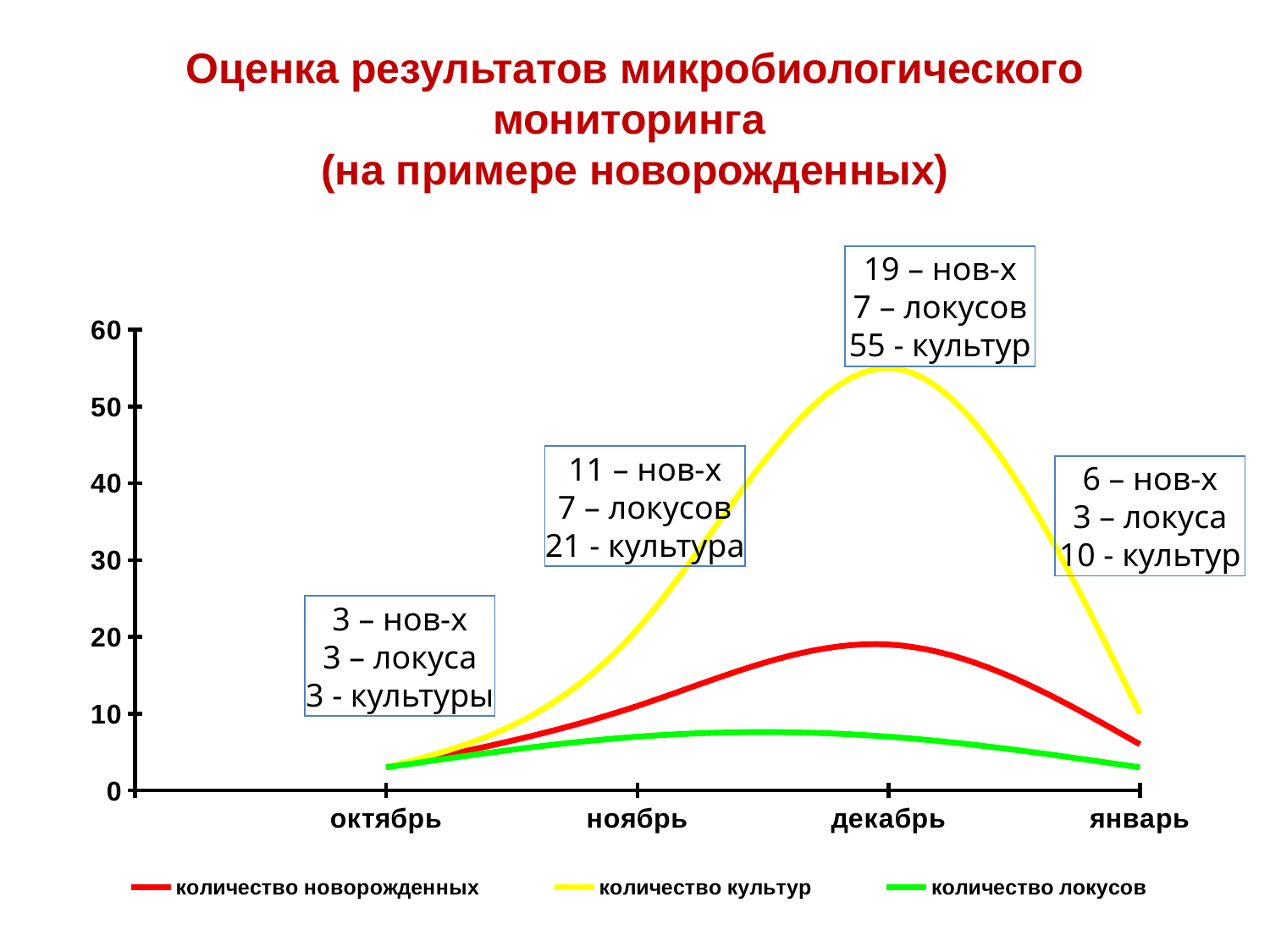
In which month is the number of newborns (количество новорожденных) lowest? октябрь In which month is the number of cultures (количество культур) highest? декабрь How many months are shown on the x axis? 4 What kind of chart is shown on the slide? line chart Which is larger in январь: the number of cultures or the number of newborns? количество культур How many series does the legend list? 3 Which colour is used for the количество локусов series? green What is the difference between the number of cultures in декабрь and in ноябрь? 34 What is the number of newborns (количество новорожденных) in ноябрь? 11 Does the number of cultures (количество культур) rise or fall from декабрь to январь? fall What is the number of loci (количество локусов) in январь? 3 What is the number of cultures (количество культур) in декабрь? 55